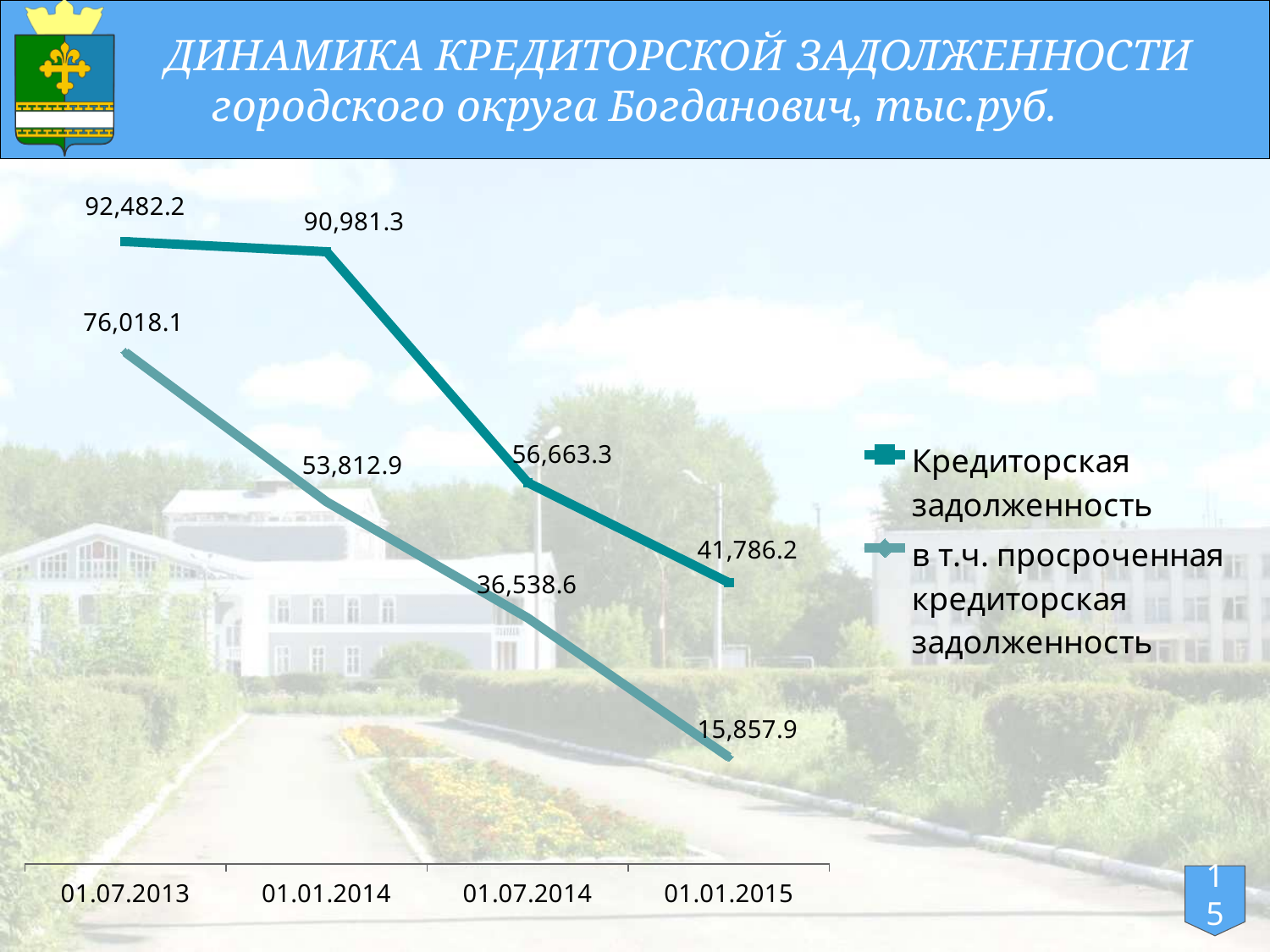
What is the difference between Кредиторская задолженность on 01.07.2013 and on 01.01.2015? 50,696.0 What is the value of в т.ч. просроченная кредиторская задолженность on 01.01.2014? 53,812.9 Which is larger on 01.01.2015: Кредиторская задолженность or в т.ч. просроченная кредиторская задолженность? Кредиторская задолженность What is the value of Кредиторская задолженность on 01.07.2014? 56,663.3 On which date is в т.ч. просроченная кредиторская задолженность highest? 01.07.2013 On which date is Кредиторская задолженность lowest? 01.01.2015 What type of chart is shown on the slide? line chart What is the value of в т.ч. просроченная кредиторская задолженность on 01.01.2015? 15,857.9 Do the values of Кредиторская задолженность rise or fall from 01.07.2013 to 01.01.2015? fall How many dates are shown on the x axis? 4 How many series does the legend list? 2 What is the value of Кредиторская задолженность on 01.07.2013? 92,482.2